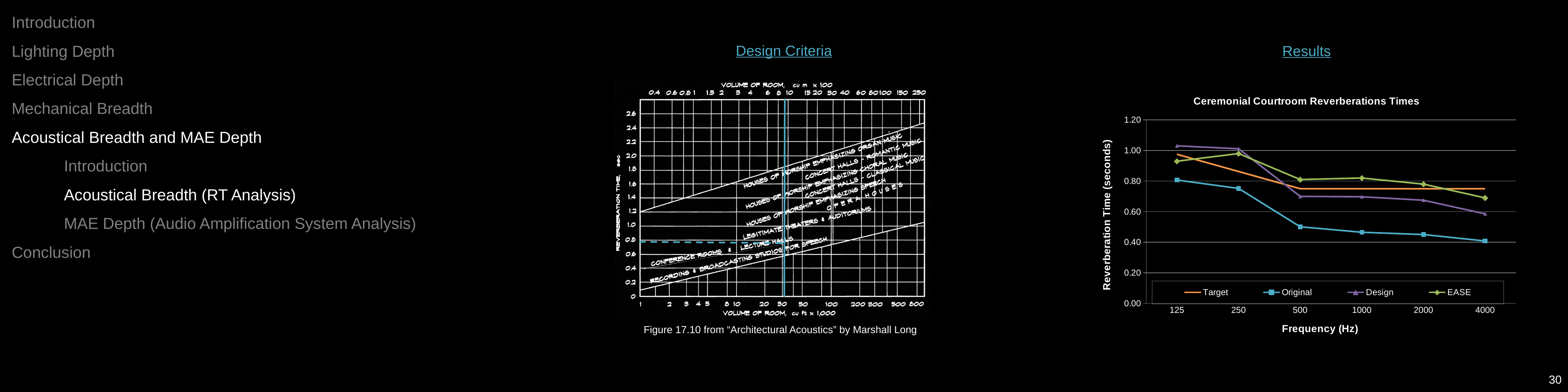
What kind of chart is "Ceremonial Courtroom Reverberations Times"? line chart What is the label of the y axis in the "Ceremonial Courtroom Reverberations Times" chart? Reverberation Time (seconds) In the "Ceremonial Courtroom Reverberations Times" chart, which series has the lowest value at 4000 Hz? Original In the "Ceremonial Courtroom Reverberations Times" chart, is the EASE value at 125 Hz greater or less than 0.80? greater In the "Ceremonial Courtroom Reverberations Times" chart, is the Original value at 500 Hz greater or less than 0.60? less How many series does the legend of the "Ceremonial Courtroom Reverberations Times" chart list? 4 In the "Ceremonial Courtroom Reverberations Times" chart, which series has the highest value at 125 Hz? Design In the "Ceremonial Courtroom Reverberations Times" chart, does the Original series rise or fall as frequency increases from 125 Hz to 4000 Hz? fall In the "Ceremonial Courtroom Reverberations Times" chart, at 4000 Hz, which is larger: the EASE value or the Original value? EASE In the "Ceremonial Courtroom Reverberations Times" chart, at 500 Hz, which is larger: the Design value or the Original value? Design How many frequency values are plotted along the x axis of the "Ceremonial Courtroom Reverberations Times" chart? 6 In the "Ceremonial Courtroom Reverberations Times" chart, is the Target value at 4000 Hz greater or less than 0.60? greater